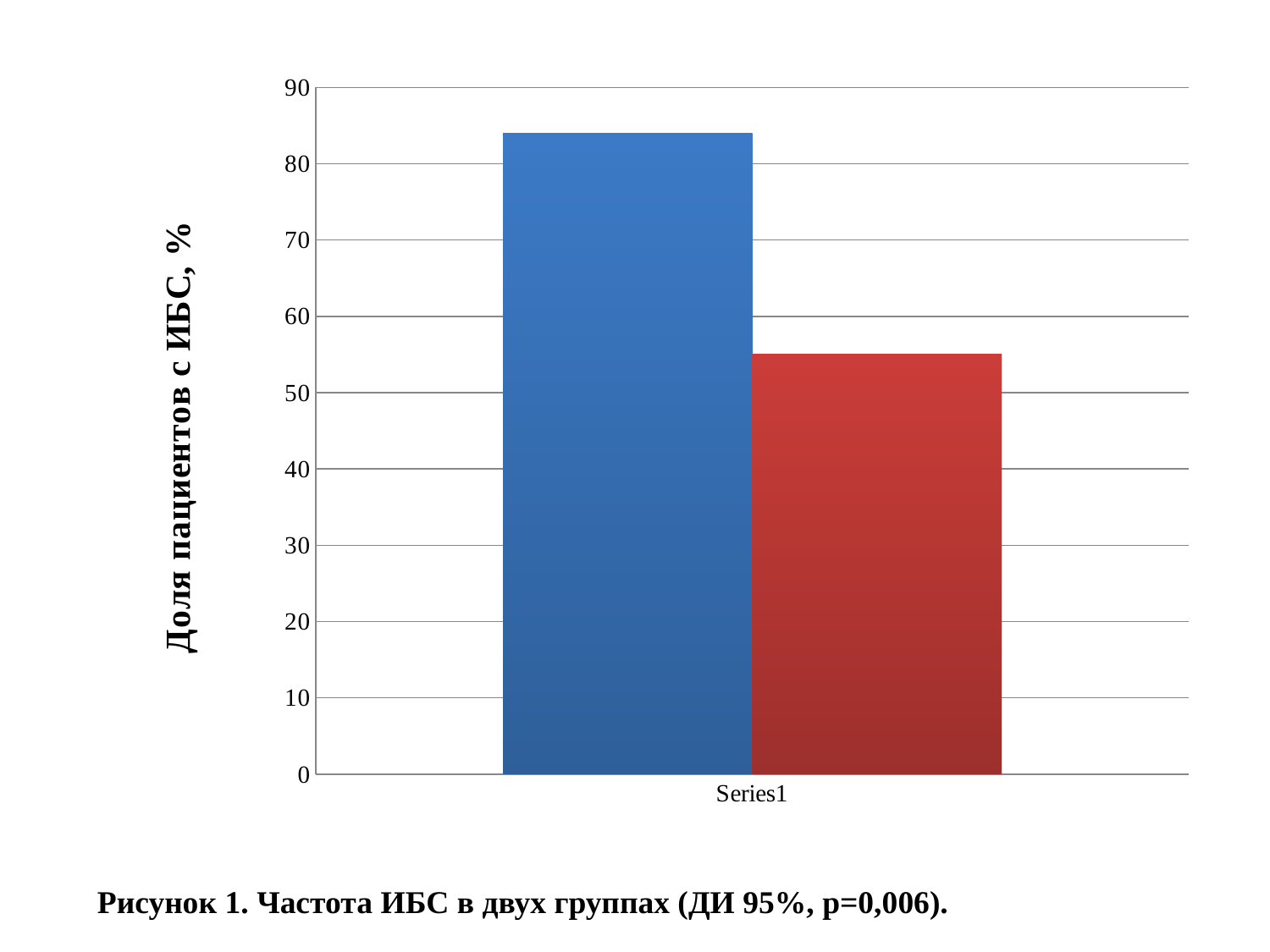
Is the value of the red bar greater or less than 60? less What is the category label shown under the bars on the horizontal axis? Series1 Which bar has the lowest value in the chart? the red bar Which bar is taller, the blue bar or the red bar? the blue bar Is the value of the blue bar greater or less than 90? less What is the title of the vertical axis? Доля пациентов с ИБС, % Is the value of the blue bar greater or less than 80? greater Which bar has the highest value in the chart? the blue bar How many bars are plotted in the chart? 2 What kind of chart is shown on the slide? bar chart